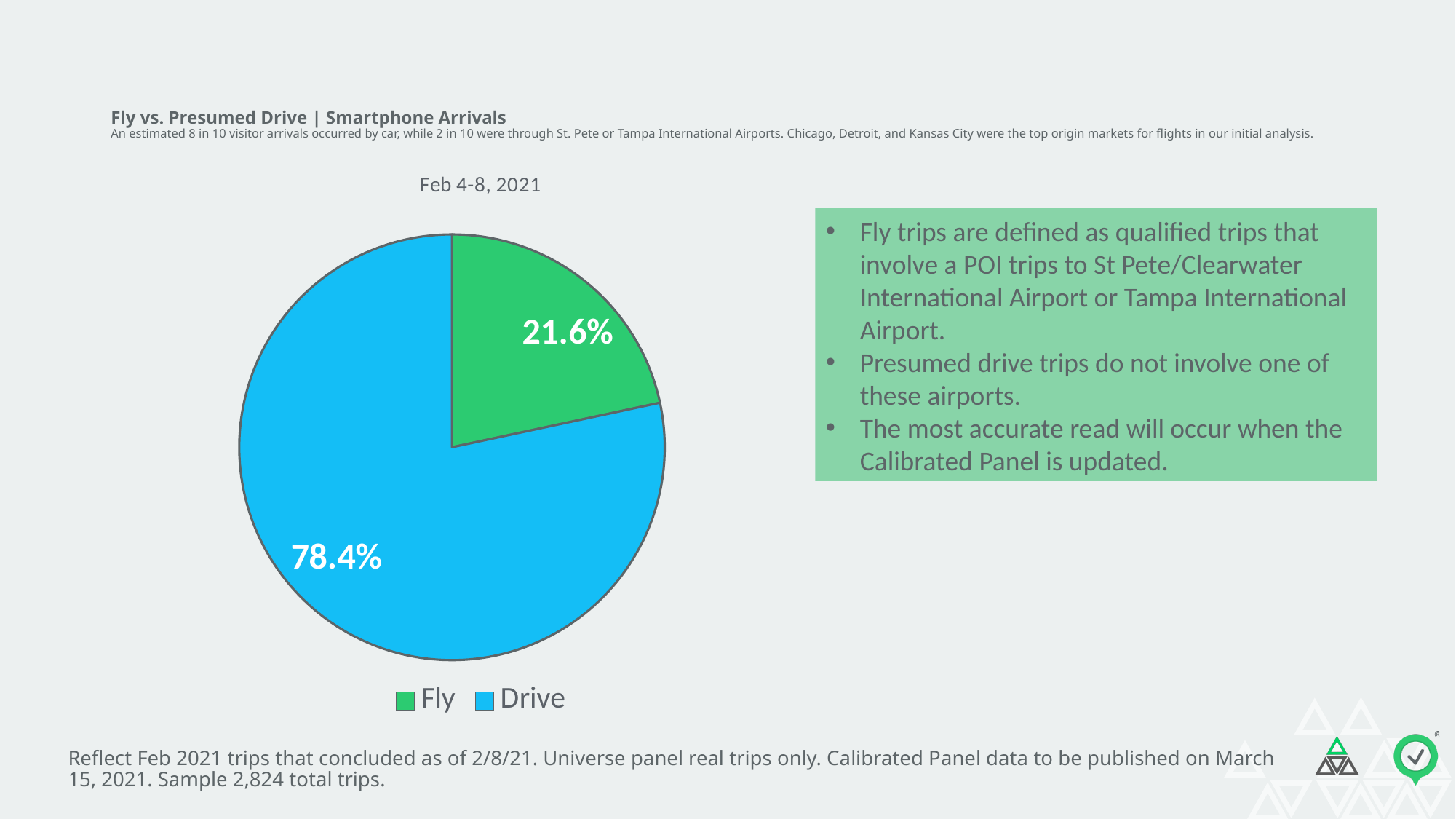
What is the combined share of the Fly and Drive slices? 100% What share of arrivals does the Fly slice represent? 21.6% Which category has the smallest share of the pie? Fly Which is larger, the Fly share or the Drive share? Drive Which category has the largest share of the pie? Drive What is the title shown above the pie chart? Feb 4-8, 2021 How many entries does the legend list? 2 What is the difference in percentage points between the Drive and Fly shares? 56.8 How many slices does the pie chart have? 2 What share of arrivals does the Drive slice represent? 78.4% What kind of chart is shown on the slide? Pie chart What colour is the Fly slice in the pie chart? Green